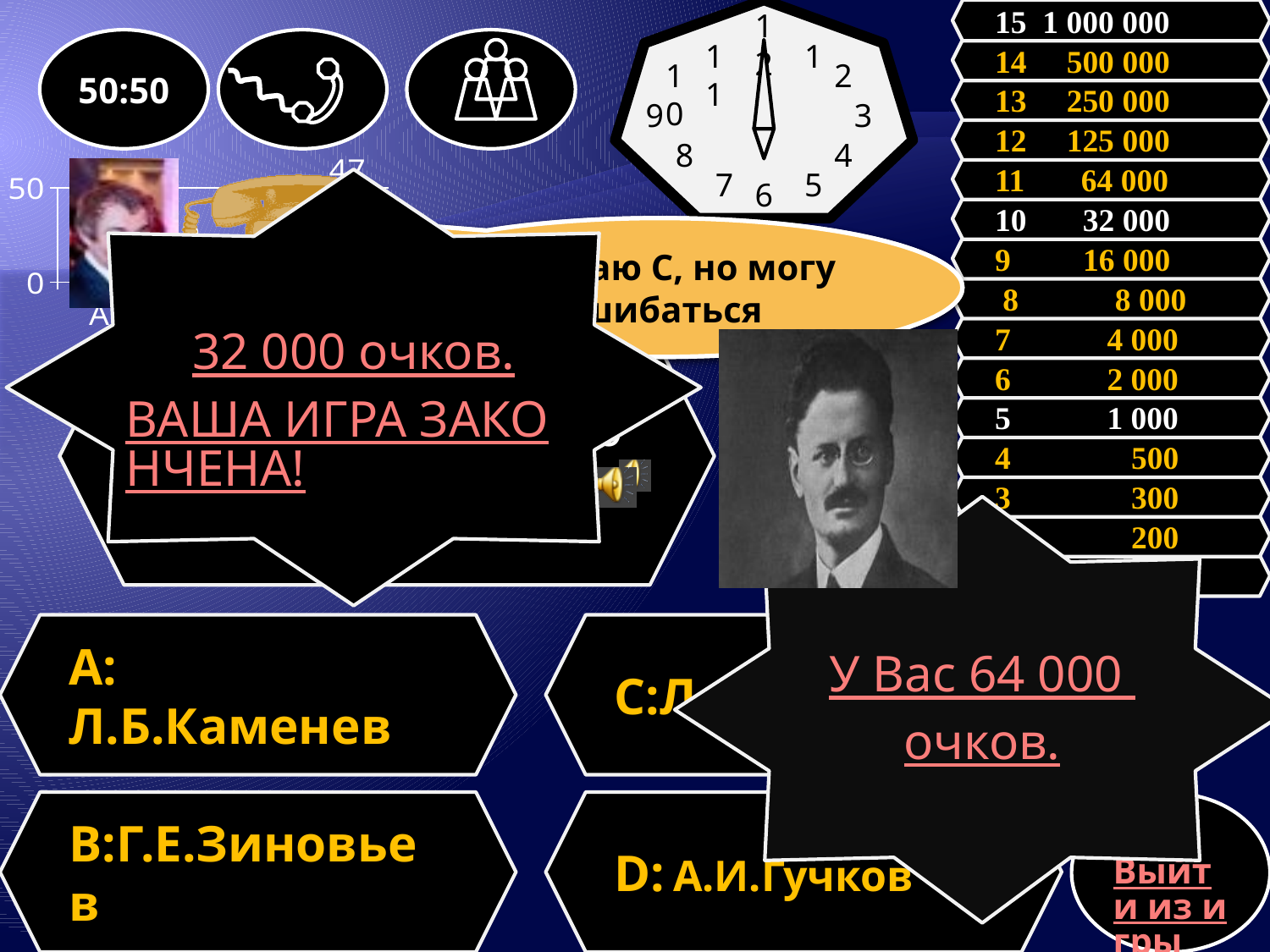
What is the highest tick value shown on the y axis of the chart at the top left of the slide? 50 Is the value labelled on the chart at the top left of the slide greater or less than 50? less What data label is printed on the partially visible chart at the top left of the slide? 47